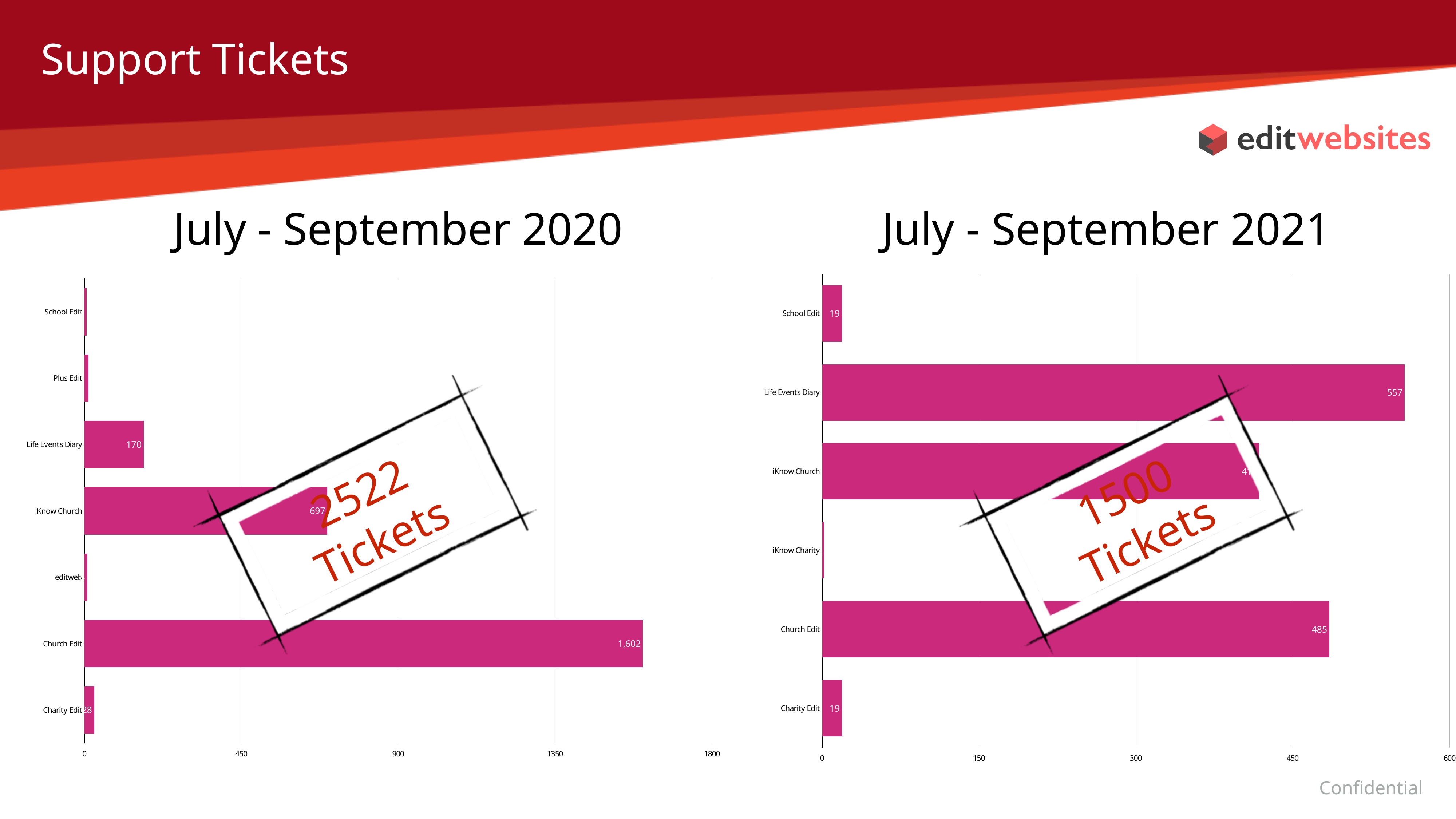
How many categories are shown in the July - September 2021 chart? 6 In the July - September 2020 chart, what is the value for Church Edit? 1,602 What kind of chart is the July - September 2020 chart? bar chart In the July - September 2020 chart, what is the value for iKnow Church? 697 In the July - September 2021 chart, which category has the lowest value? iKnow Charity In the July - September 2020 chart, what is the difference between Church Edit and iKnow Church? 905 In the July - September 2020 chart, which category has the highest value? Church Edit In the July - September 2021 chart, what is the value for Life Events Diary? 557 In the July - September 2021 chart, which category has the highest value? Life Events Diary In the July - September 2020 chart, what is the value for Life Events Diary? 170 In the July - September 2021 chart, is the value for iKnow Church greater or less than 300? greater In the July - September 2021 chart, what is the value for Church Edit? 485